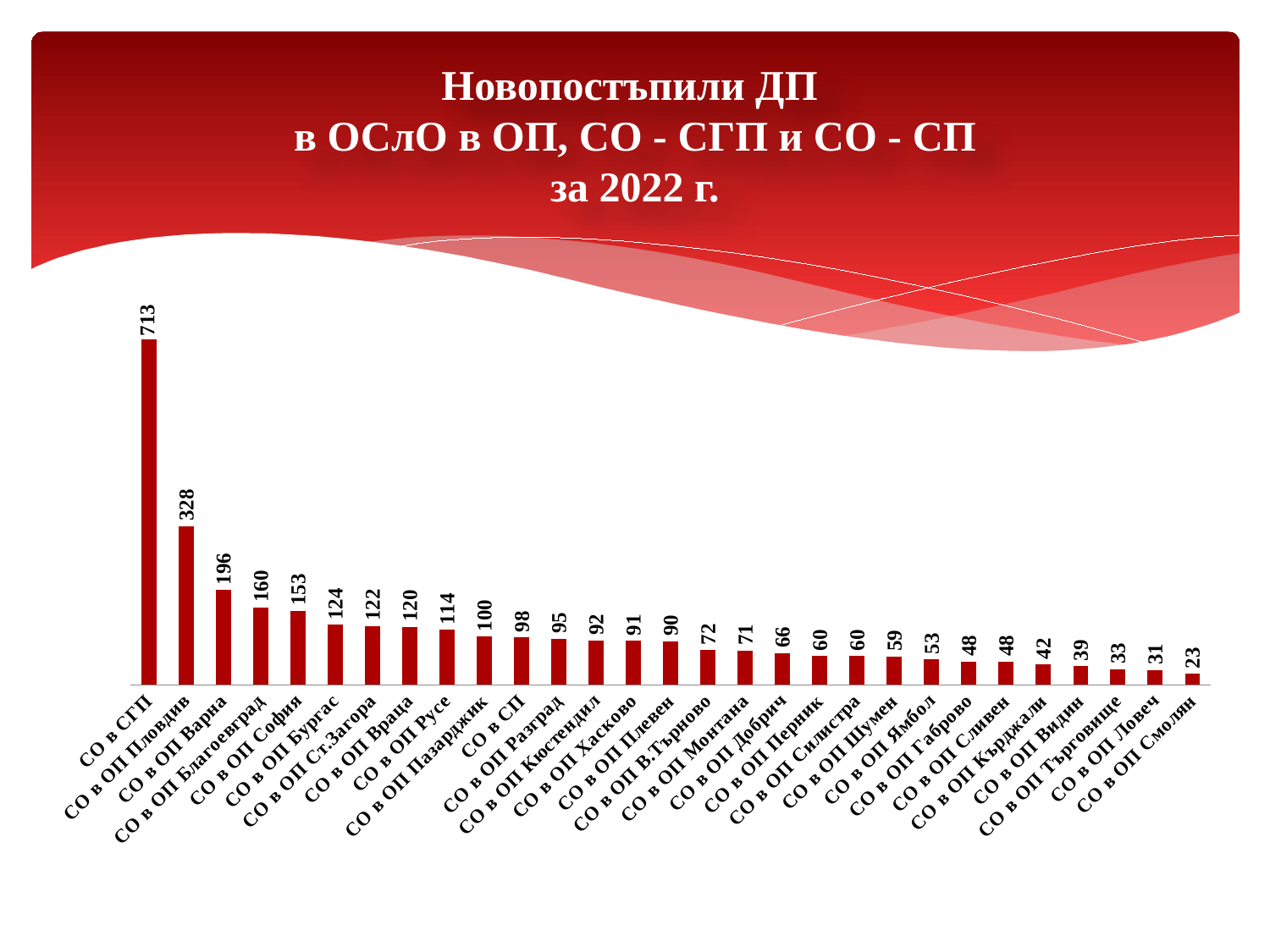
What kind of chart is shown on the slide? Bar chart What is the value for СО в СП? 98 What is the value for СО в СГП? 713 How many categories are shown in the chart? 29 Which category has the lowest value? СО в ОП Смолян What is the difference between the values for СО в СГП and СО в ОП Пловдив? 385 Which category has the highest value? СО в СГП What is the value for СО в ОП Смолян? 23 Do the values rise or fall from left to right along the x axis? Fall Which is larger, the value for СО в ОП Бургас or the value for СО в ОП Русе? СО в ОП Бургас What is the value for СО в ОП Пловдив? 328 What is the value for СО в ОП Варна? 196